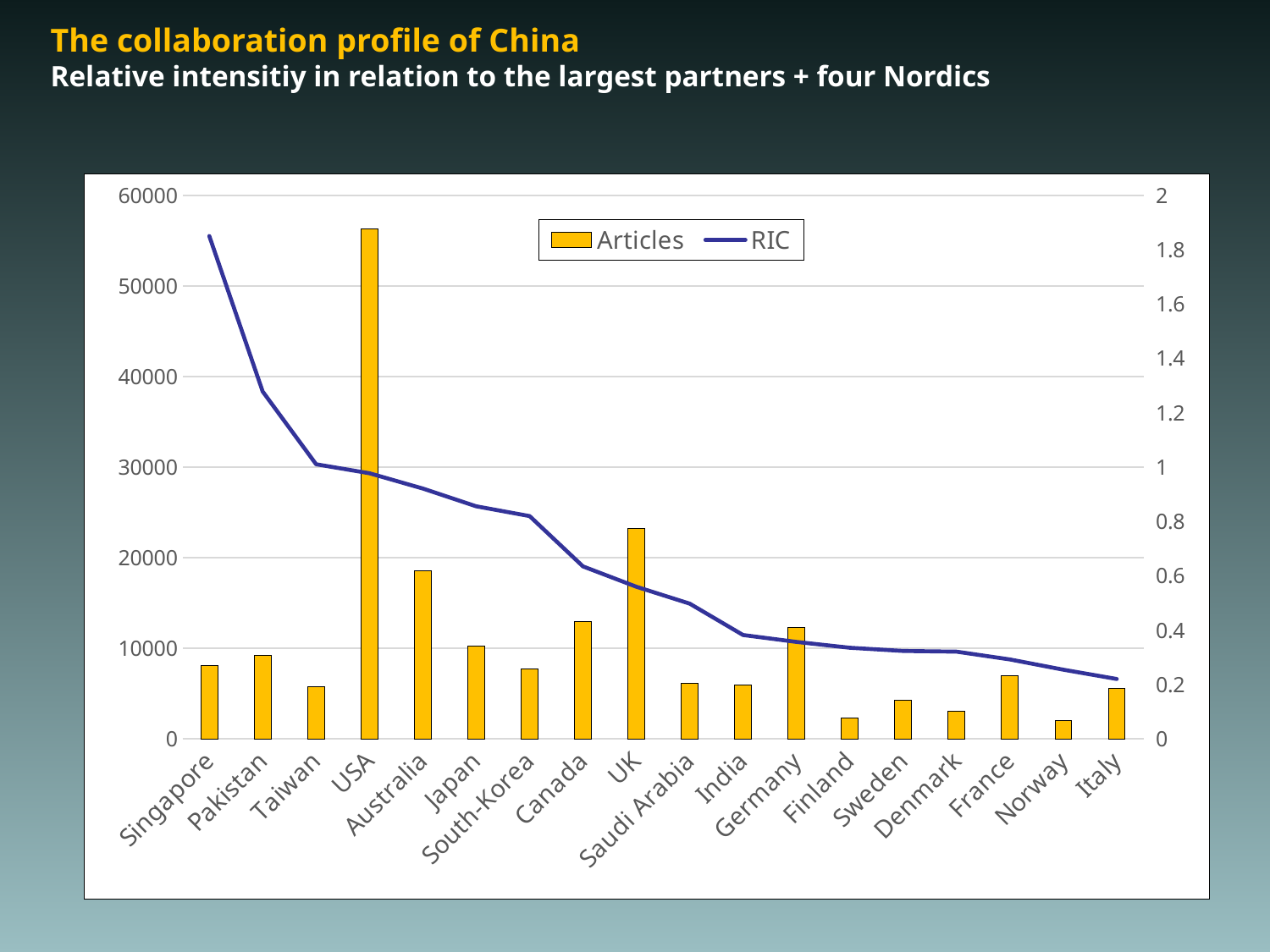
Which country has the highest number of Articles? USA Is the number of Articles for the USA greater or less than 50000? greater Is the number of Articles for the UK greater or less than 20000? greater Which country has the highest RIC value? Singapore What kind of chart is shown on the slide? A combined bar and line chart Does the RIC line rise or fall from left to right along the x axis? Fall Which series is plotted as a line in the chart? RIC How many countries are shown on the x axis? 18 Which has more Articles, the UK or Australia? UK Which country has the lowest RIC value? Italy How many series does the legend list? 2